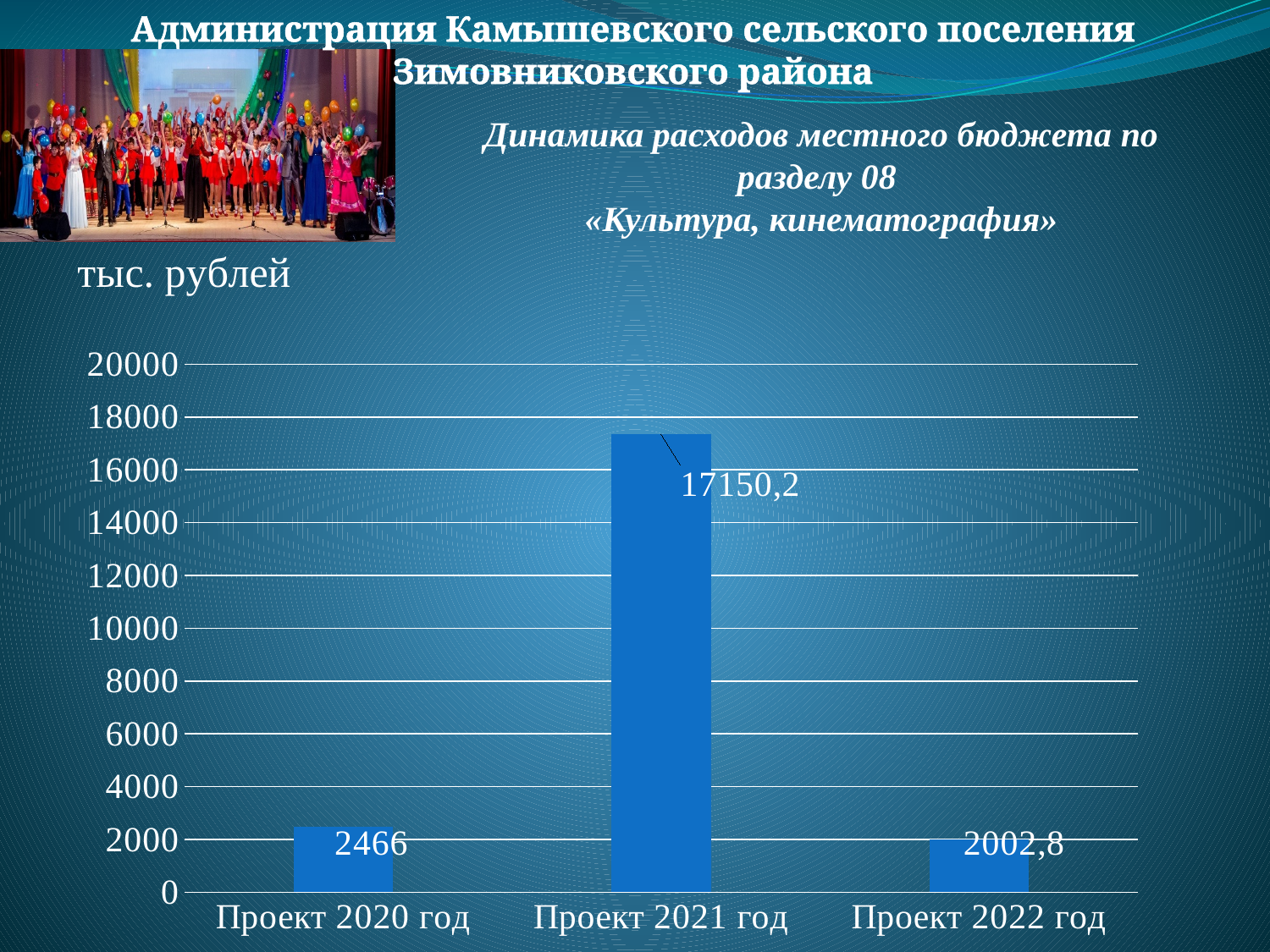
Which category has the lowest value? Проект 2022 год What is the difference between the values for Проект 2021 год and Проект 2020 год? 14684,2 Which is larger, the value for Проект 2020 год or Проект 2022 год? Проект 2020 год What is the difference between the values for Проект 2020 год and Проект 2022 год? 463,2 How many categories are shown on the x axis? 3 Is the value for Проект 2021 год greater or less than 16000? greater Does the value rise or fall from Проект 2021 год to Проект 2022 год? fall What is the value for Проект 2021 год? 17150,2 What kind of chart is shown on the slide? bar chart What is the value for Проект 2020 год? 2466 What is the value for Проект 2022 год? 2002,8 Which category has the highest value? Проект 2021 год